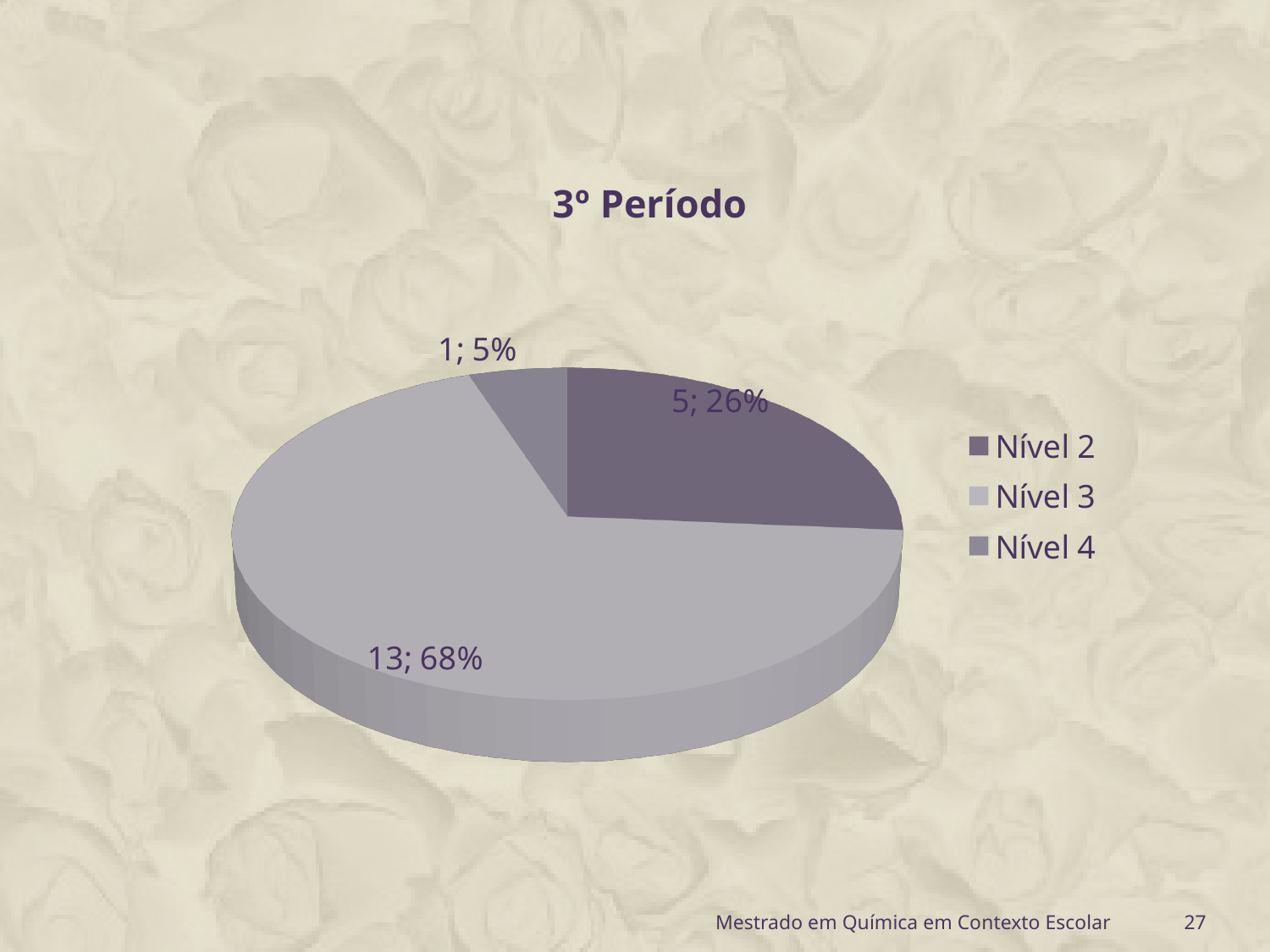
What is the count for Nível 3? 13 Which category has the smallest slice? Nível 4 What share of the pie does Nível 3 represent? 68% What share of the pie does Nível 2 represent? 26% How many entries does the legend list? 3 What is the count for Nível 4? 1 What is the count for Nível 2? 5 What kind of chart is shown on the slide? pie chart Which category has the largest slice? Nível 3 What is the title of the chart? 3º Período How many slices does the pie chart have? 3 What is the difference between the counts for Nível 3 and Nível 2? 8